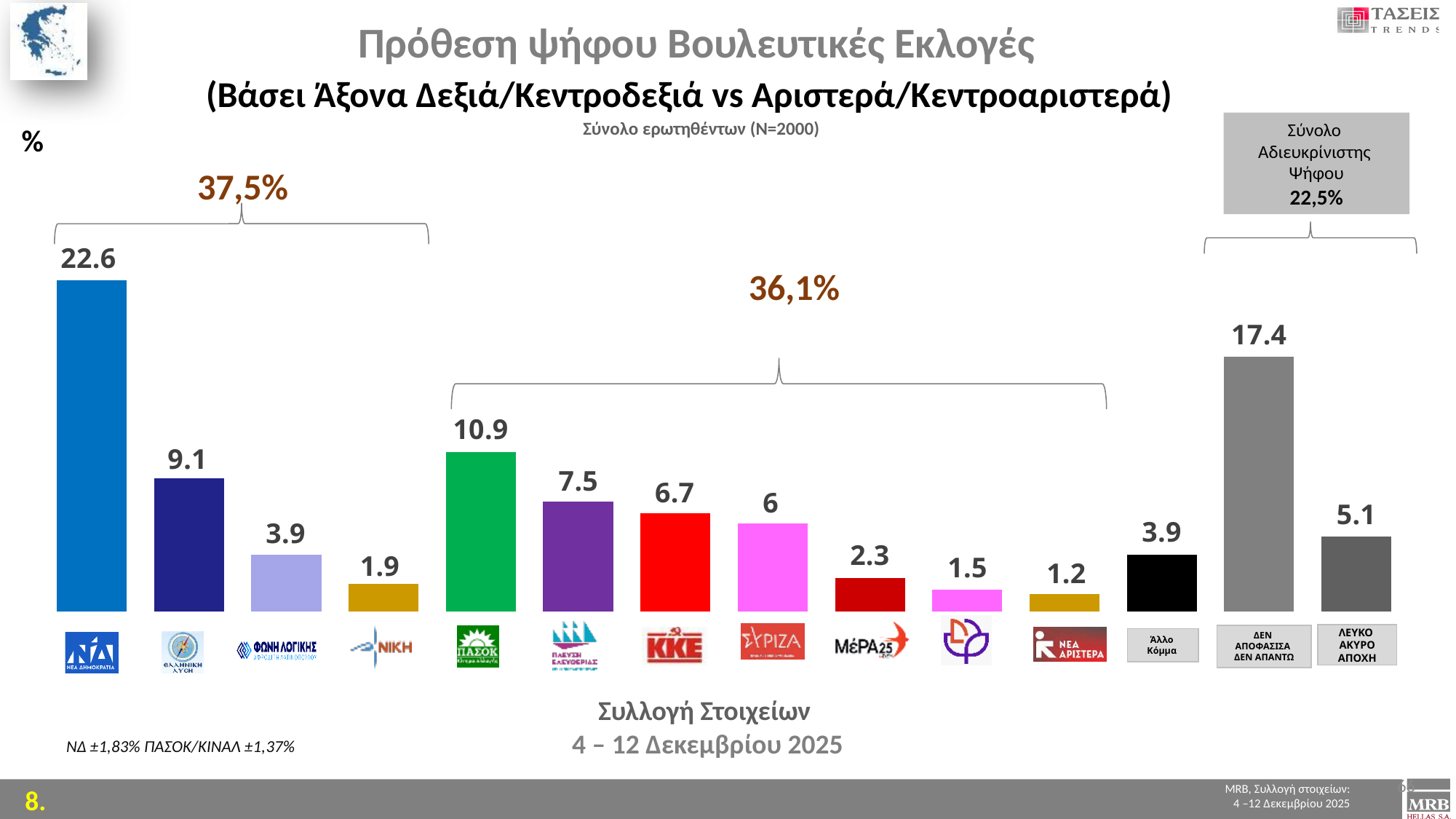
What is the difference between the values for ΝΔ and ΠΑΣΟΚ? 11.7 What is the value shown for ΚΚΕ? 6.7 What is the value shown for ΔΕΝ ΑΠΟΦΑΣΙΣΑ / ΔΕΝ ΑΠΑΝΤΩ? 17.4 What kind of chart is shown on the slide? Bar chart Which party bar has the highest value on the chart? ΝΔ (Νέα Δημοκρατία) What is the value shown for ΝΔ (Νέα Δημοκρατία)? 22.6 Which labelled bar has the lowest value on the chart? ΝΕΑ ΑΡΙΣΤΕΡΑ (1.2) How many bars are plotted on the chart? 14 What is the total for 'Σύνολο Αδιευκρίνιστης Ψήφου' shown in the grey box? 22,5% Which has a larger value, ΣΥΡΙΖΑ or Πλεύση Ελευθερίας? Πλεύση Ελευθερίας What total percentage is shown above the bracket grouping the right/centre-right parties (ΝΔ to ΝΙΚΗ)? 37,5% What is the value shown for ΠΑΣΟΚ? 10.9